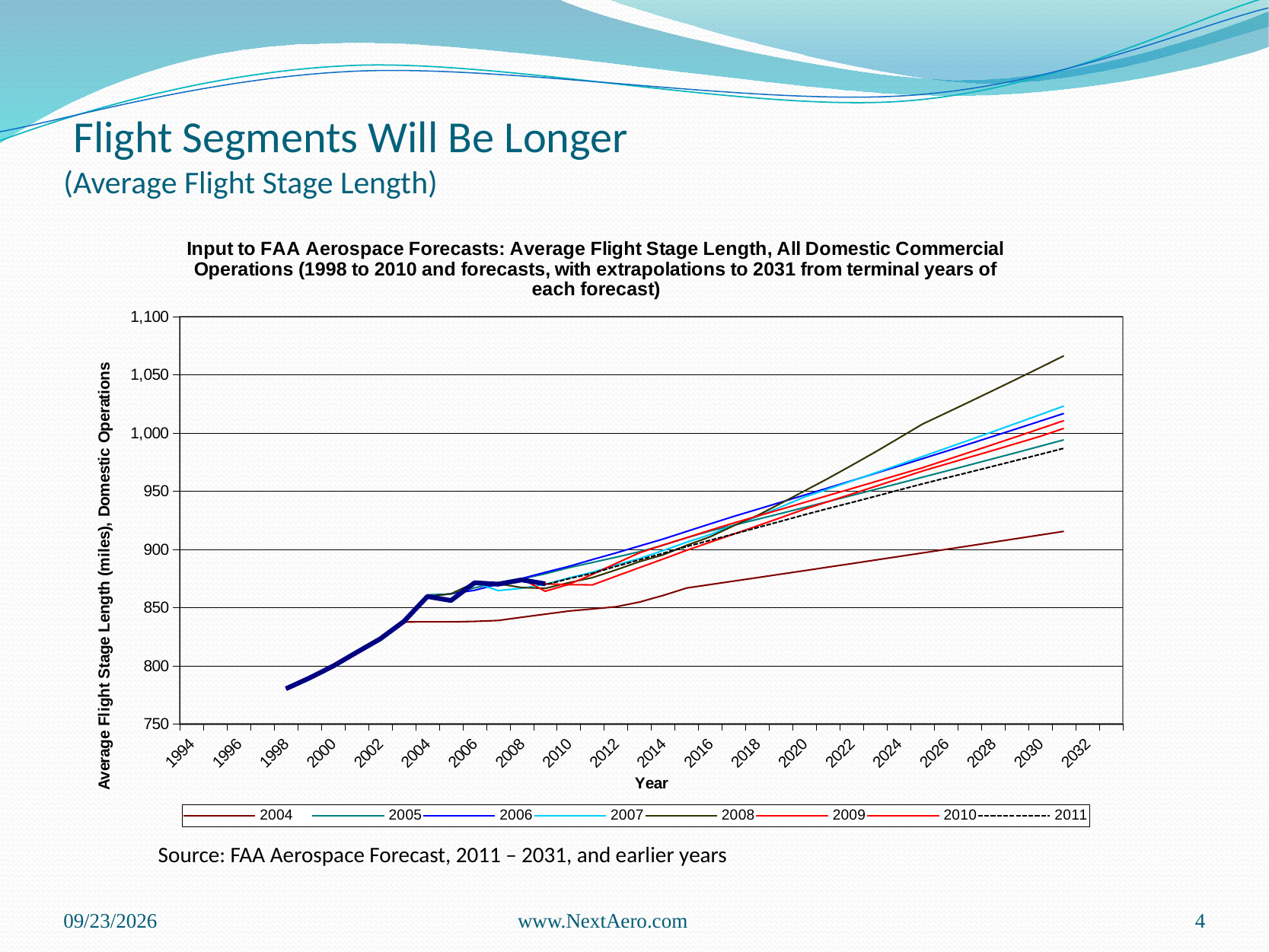
Is the value of the 2004 forecast series at 2031 greater or less than 950? less Which forecast series has the lowest value at the right end of the chart (2031)? 2004 Is the value of the dashed 2011 forecast series at 2031 greater or less than 1,000? less What is the label of the chart's x axis? Year How many series does the chart's legend list? 8 Which forecast series reaches the highest value at the right end of the chart (2031)? 2008 At 2031, which is larger: the 2008 forecast series or the 2011 forecast series? 2008 Do the forecast lines generally rise or fall as the year increases along the x axis? rise Is the value of the 2008 forecast series at 2031 greater or less than 1,050? greater What is the label of the chart's y axis? Average Flight Stage Length (miles), Domestic Operations What kind of chart is shown on the slide? line chart